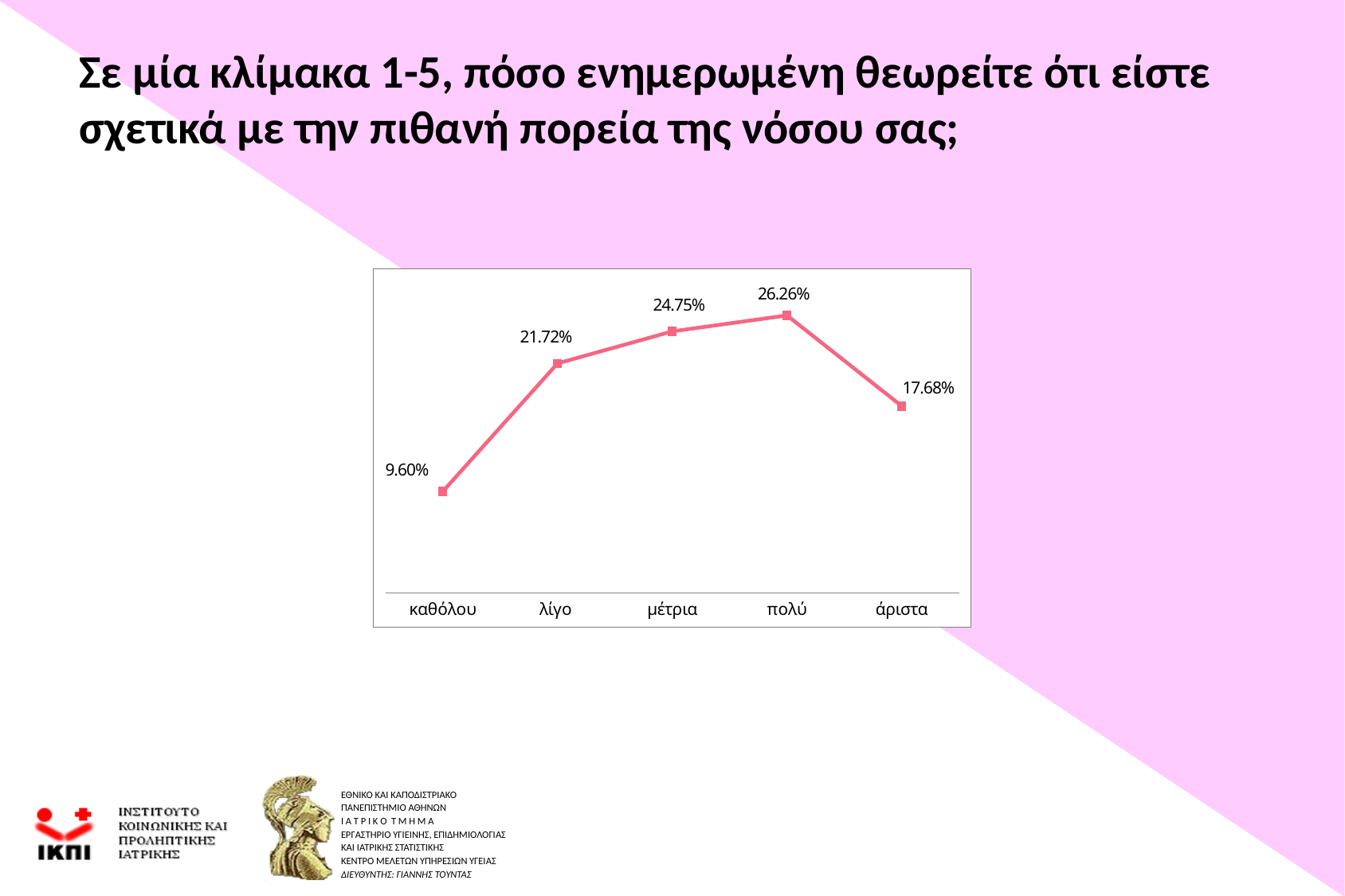
What is the value for πολύ? 26.26% What is the value for μέτρια? 24.75% How many categories are shown on the x axis? 5 What is the value for άριστα? 17.68% What kind of chart is shown on the slide? line chart Which is larger, the value for λίγο or the value for άριστα? λίγο What is the difference between the values for πολύ and καθόλου? 16.66% Which category has the lowest value? καθόλου What is the value for καθόλου? 9.60% What is the difference between the values for μέτρια and λίγο? 3.03% What is the value for λίγο? 21.72% Which category has the highest value? πολύ